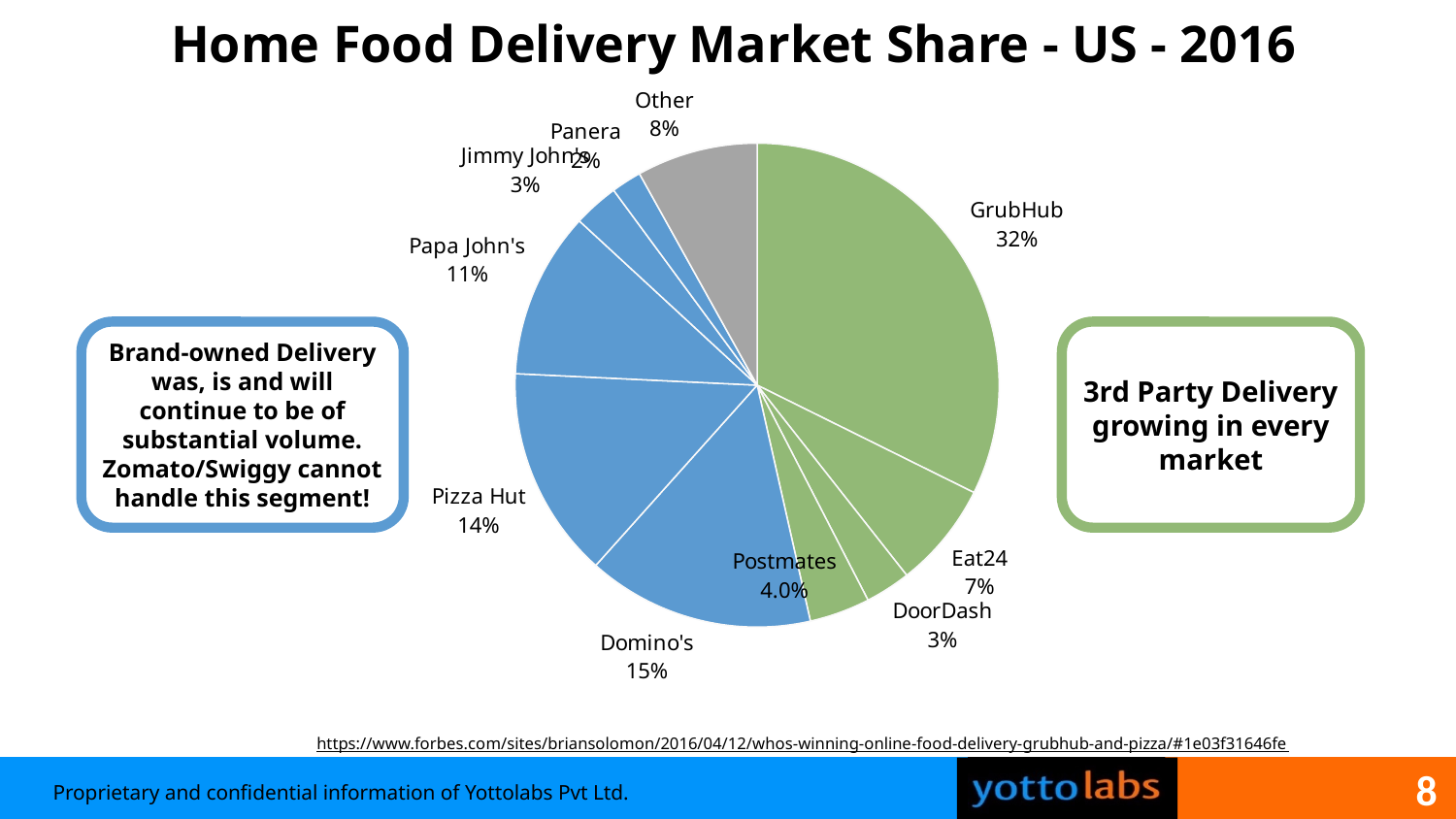
Which category has the largest share of the pie? GrubHub What is the difference between the shares of Domino's and Pizza Hut? 1% What is the market share for Papa John's? 11% What is the title of the chart? Home Food Delivery Market Share - US - 2016 What is the market share for GrubHub? 32% Which has a larger share, Eat24 or DoorDash? Eat24 What is the market share for Domino's? 15% What is the difference between the shares of GrubHub and Other? 24% What kind of chart is shown on the slide? pie chart How many slices does the pie chart have? 10 Which category has the smallest share of the pie? Panera What is the market share for Postmates? 4.0%